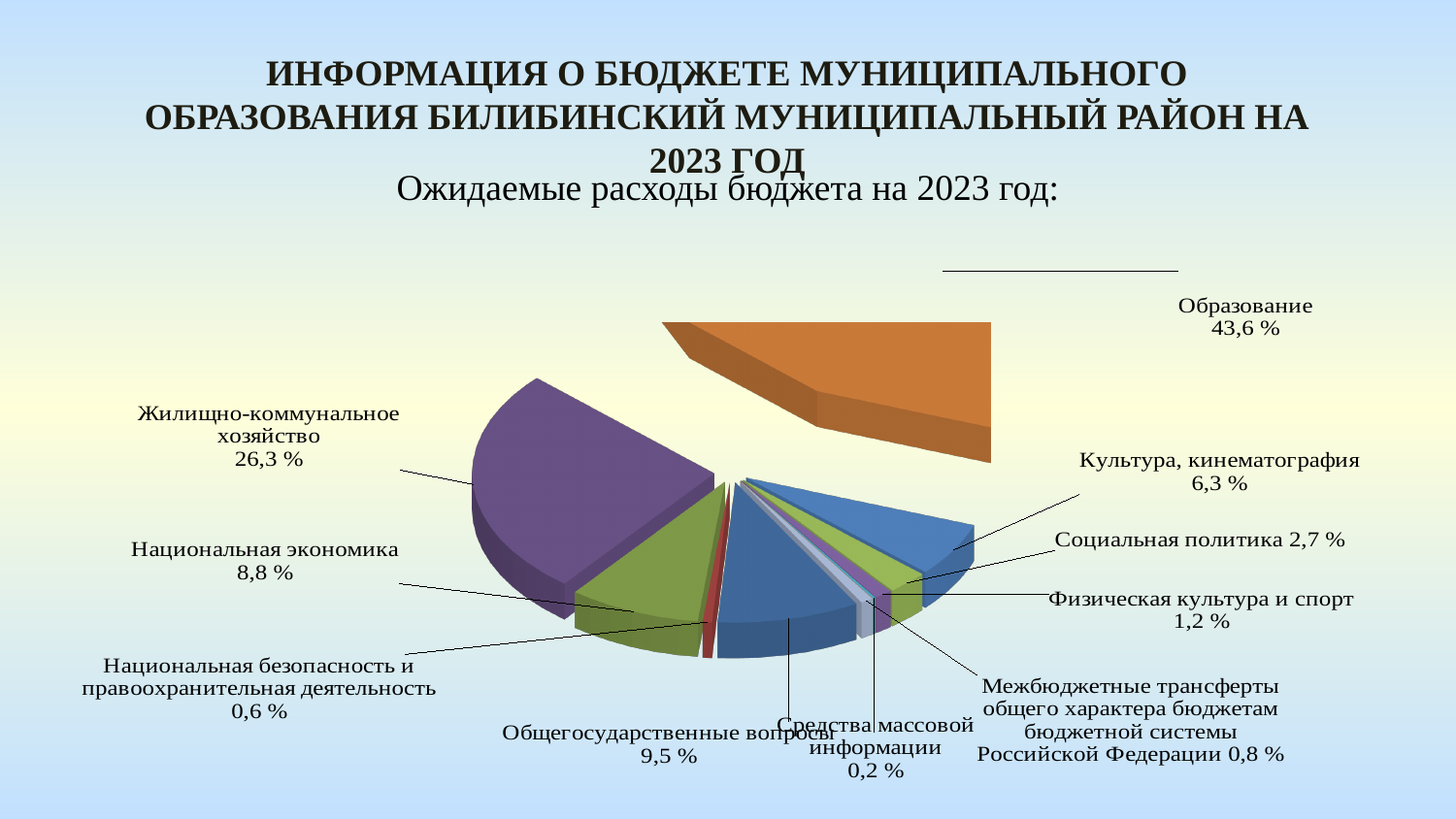
What kind of chart is shown on the slide? Pie chart What share of expected 2023 budget expenditure goes to Образование? 43,6 % Which category has the smallest share of the pie? Средства массовой информации What is the subtitle shown above the chart? Ожидаемые расходы бюджета на 2023 год: Which is larger: Национальная экономика or Общегосударственные вопросы? Общегосударственные вопросы What share is labelled for Средства массовой информации? 0,2 % What is the value for Культура, кинематография? 6,3 % Which category has the largest share of the pie? Образование What percentage is shown for Общегосударственные вопросы? 9,5 % What is the difference between the shares of Образование and Жилищно-коммунальное хозяйство? 17,3 % What is the value shown for Жилищно-коммунальное хозяйство? 26,3 % How many categories are shown in the pie chart? 10